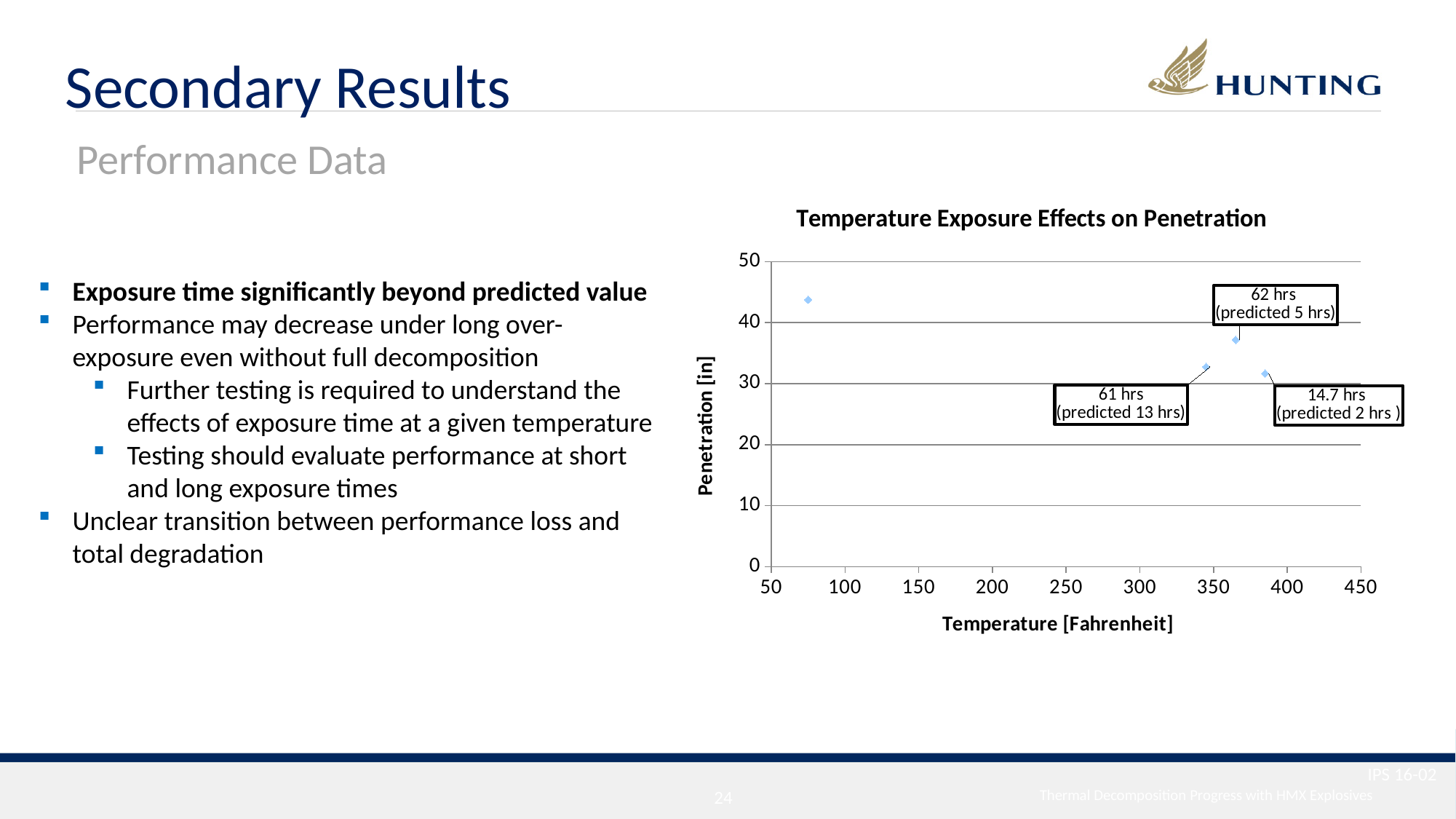
Is the penetration value for the point labelled '61 hrs (predicted 13 hrs)' greater or less than 40? less Does penetration generally rise or fall as temperature increases across the plotted points? fall What is the title of the chart? Temperature Exposure Effects on Penetration Is the penetration value for the point labelled '62 hrs (predicted 5 hrs)' greater or less than 30? greater Is the penetration value for the point labelled '14.7 hrs (predicted 2 hrs)' greater or less than 40? less What was the predicted exposure time for the point with an actual exposure of 61 hrs? 13 hrs How many data points are plotted on the chart? 4 Which plotted point has the highest penetration value? The point near 75 °F What is the label of the y axis? Penetration [in] What kind of chart is shown on the slide? Scatter chart Which point has the highest penetration: the one near 75 °F or the one labelled '62 hrs (predicted 5 hrs)'? The one near 75 °F